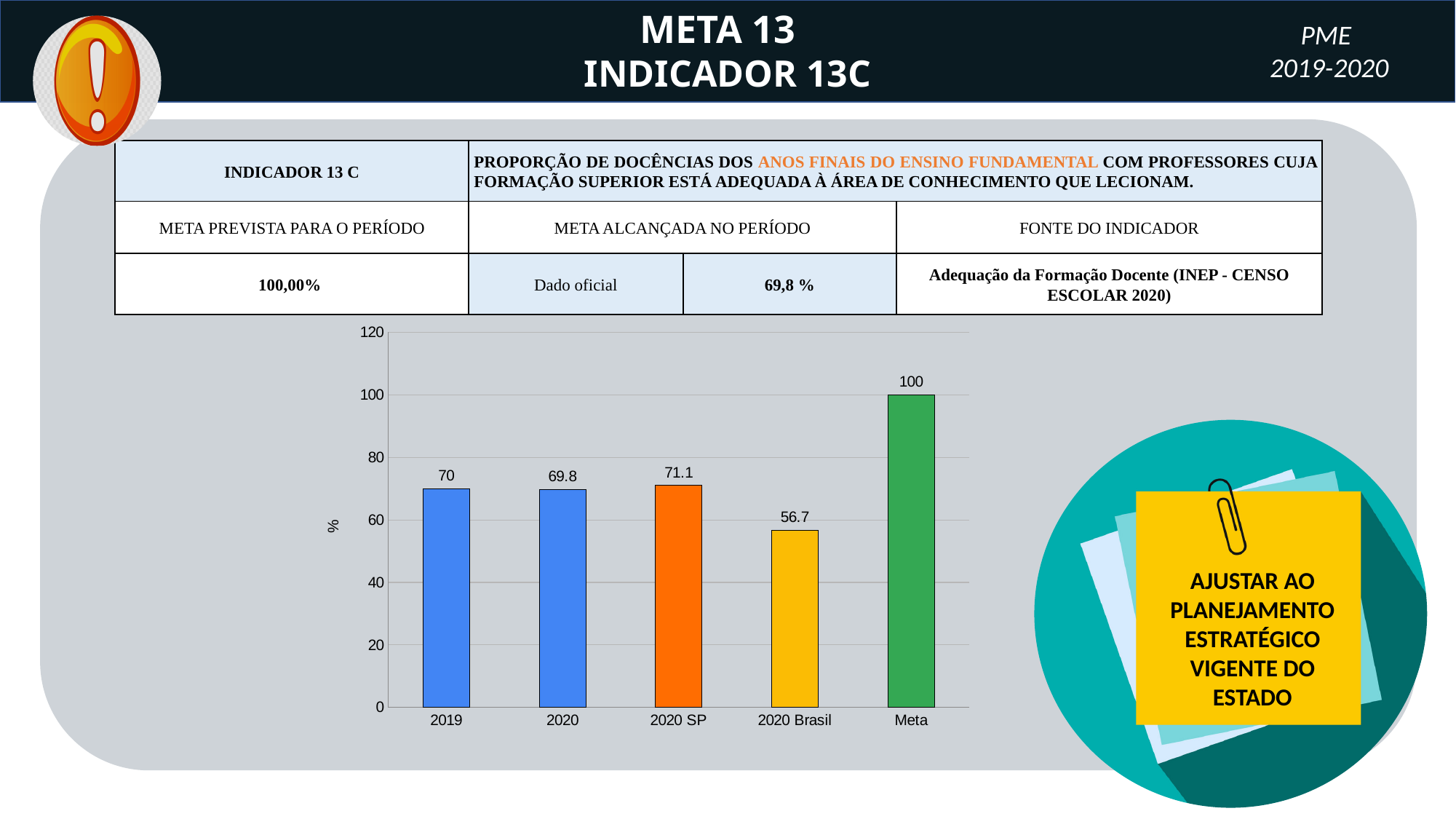
What is the difference between the 2020 SP value and the 2020 Brasil value? 14.4 What is the value for Meta in the bar chart? 100 Which category has the lowest value in the bar chart? 2020 Brasil How many categories are shown on the x axis of the bar chart? 5 What is the value for 2020 Brasil in the bar chart? 56.7 Which is larger, the value for 2020 SP or the value for 2020 Brasil? 2020 SP What is the value for 2019 in the bar chart? 70 What is the label on the vertical axis of the chart? % What kind of chart is shown on the slide? Bar chart Which category has the highest value in the bar chart? Meta What is the value for 2020 SP in the bar chart? 71.1 What is the difference between the Meta value and the 2020 value? 30.2